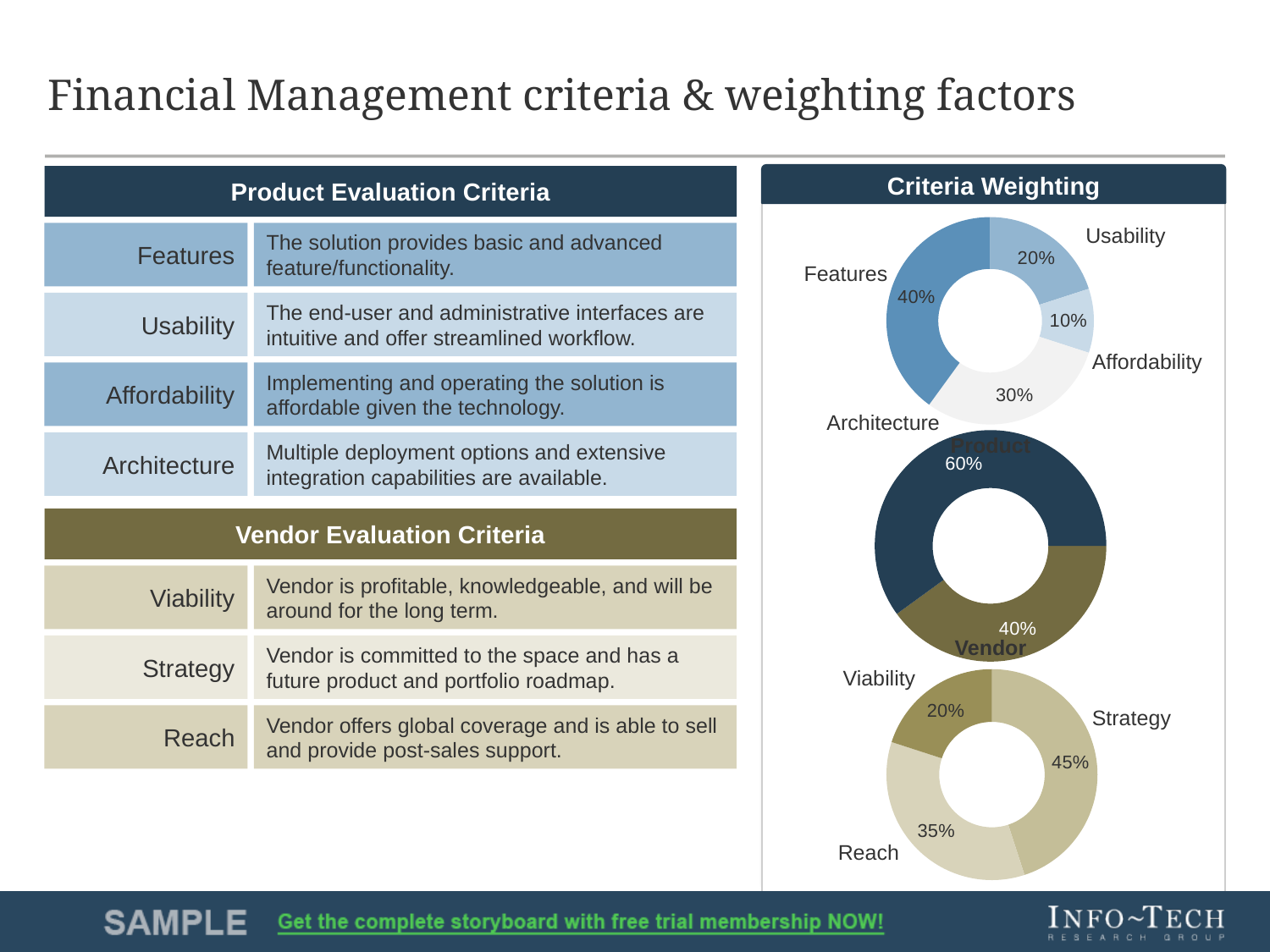
In the top donut chart under Criteria Weighting, how many criteria are shown? 4 What type of chart is used in the Criteria Weighting section? Donut chart In the top donut chart under Criteria Weighting, what is the difference between the Architecture and Usability weightings? 10% In the top donut chart under Criteria Weighting, which criterion has the highest weighting? Features In the top donut chart under Criteria Weighting, which criterion has the lowest weighting? Affordability In the middle donut chart under Criteria Weighting, which is weighted more, Product or Vendor? Product In the top donut chart under Criteria Weighting, what is the weighting for Features? 40% In the bottom donut chart under Criteria Weighting, what is the difference between the Strategy and Reach weightings? 10% In the bottom donut chart under Criteria Weighting, which criterion has the lowest weighting? Viability In the middle donut chart under Criteria Weighting, what is the weighting for Product? 60% In the top donut chart under Criteria Weighting, what is the weighting for Affordability? 10% In the bottom donut chart under Criteria Weighting, what is the weighting for Strategy? 45%